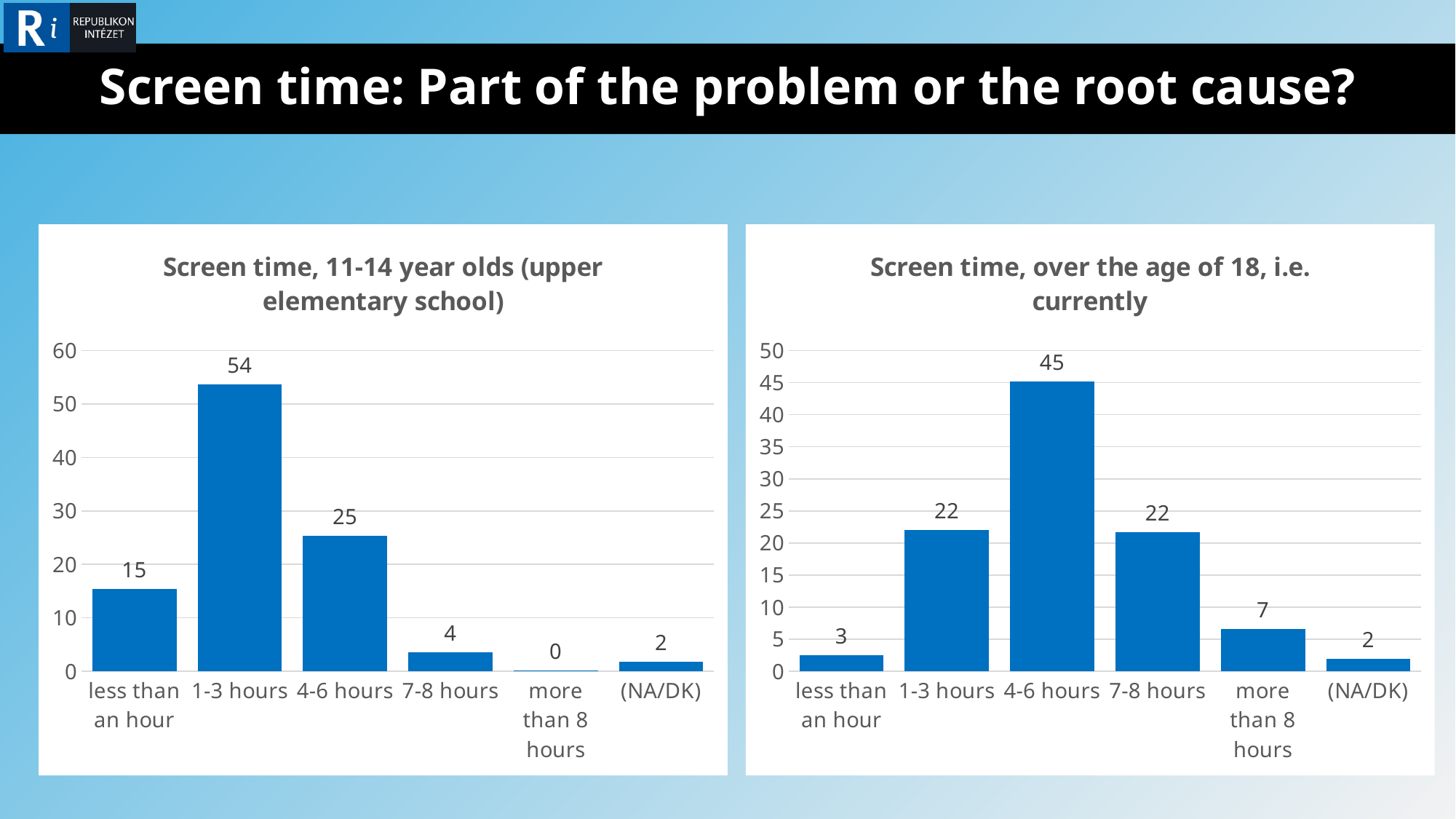
What kind of chart is 'Screen time, over the age of 18, i.e. currently'? bar chart In the chart 'Screen time, over the age of 18, i.e. currently', which is larger: the value for less than an hour or the value for more than 8 hours? more than 8 hours In the chart 'Screen time, over the age of 18, i.e. currently', what is the value for 4-6 hours? 45 In the chart 'Screen time, over the age of 18, i.e. currently', which category has the highest value? 4-6 hours In the chart 'Screen time, 11-14 year olds (upper elementary school)', which category has the lowest value? more than 8 hours In the chart 'Screen time, over the age of 18, i.e. currently', what is the difference between the values for 4-6 hours and 7-8 hours? 23 In the chart 'Screen time, 11-14 year olds (upper elementary school)', what is the value for 1-3 hours? 54 In the chart 'Screen time, 11-14 year olds (upper elementary school)', which category has the highest value? 1-3 hours In the chart 'Screen time, over the age of 18, i.e. currently', what is the value for (NA/DK)? 2 In the chart 'Screen time, 11-14 year olds (upper elementary school)', how many categories are shown on the x axis? 6 In the chart 'Screen time, 11-14 year olds (upper elementary school)', what is the difference between the values for 1-3 hours and 4-6 hours? 29 What is the title of the chart on the left side of the slide? Screen time, 11-14 year olds (upper elementary school)